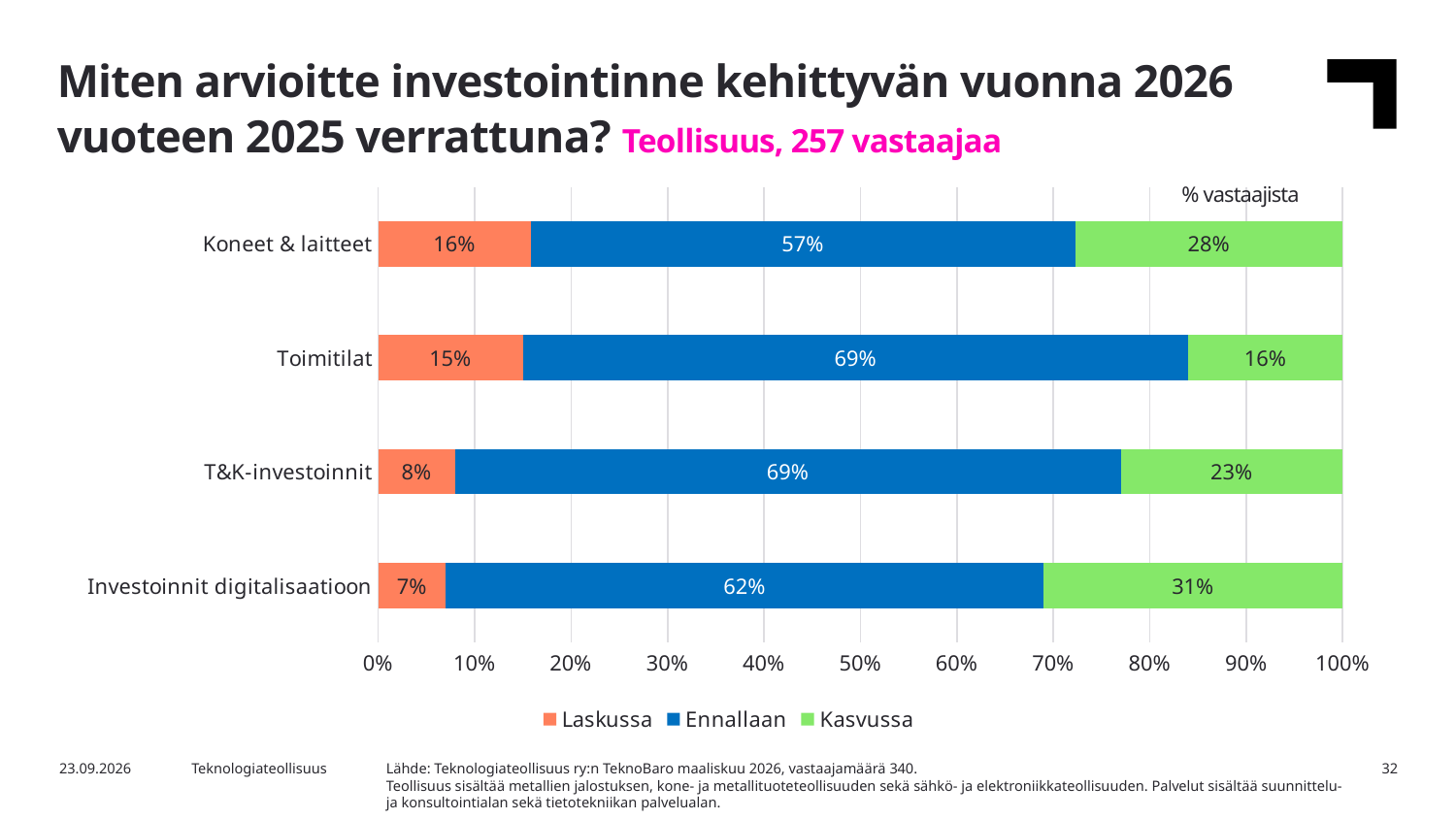
What is the difference in percentage points between the Kasvussa values for Koneet & laitteet and Toimitilat? 12 percentage points What percentage of respondents expect Koneet & laitteet investments to be Kasvussa? 28% Which category has the highest Kasvussa share? Investoinnit digitalisaatioon What is the Ennallaan value for Toimitilat? 69% What is the Kasvussa value for Investoinnit digitalisaatioon? 31% Which has a larger Ennallaan share, Toimitilat or Koneet & laitteet? Toimitilat How many series does the legend list? 3 What type of chart is shown on the slide? Stacked bar chart How many investment categories are shown in the chart? 4 What is the Laskussa value for T&K-investoinnit? 8% Which category has the lowest Laskussa share? Investoinnit digitalisaatioon What are the three legend entries of the chart? Laskussa, Ennallaan, Kasvussa